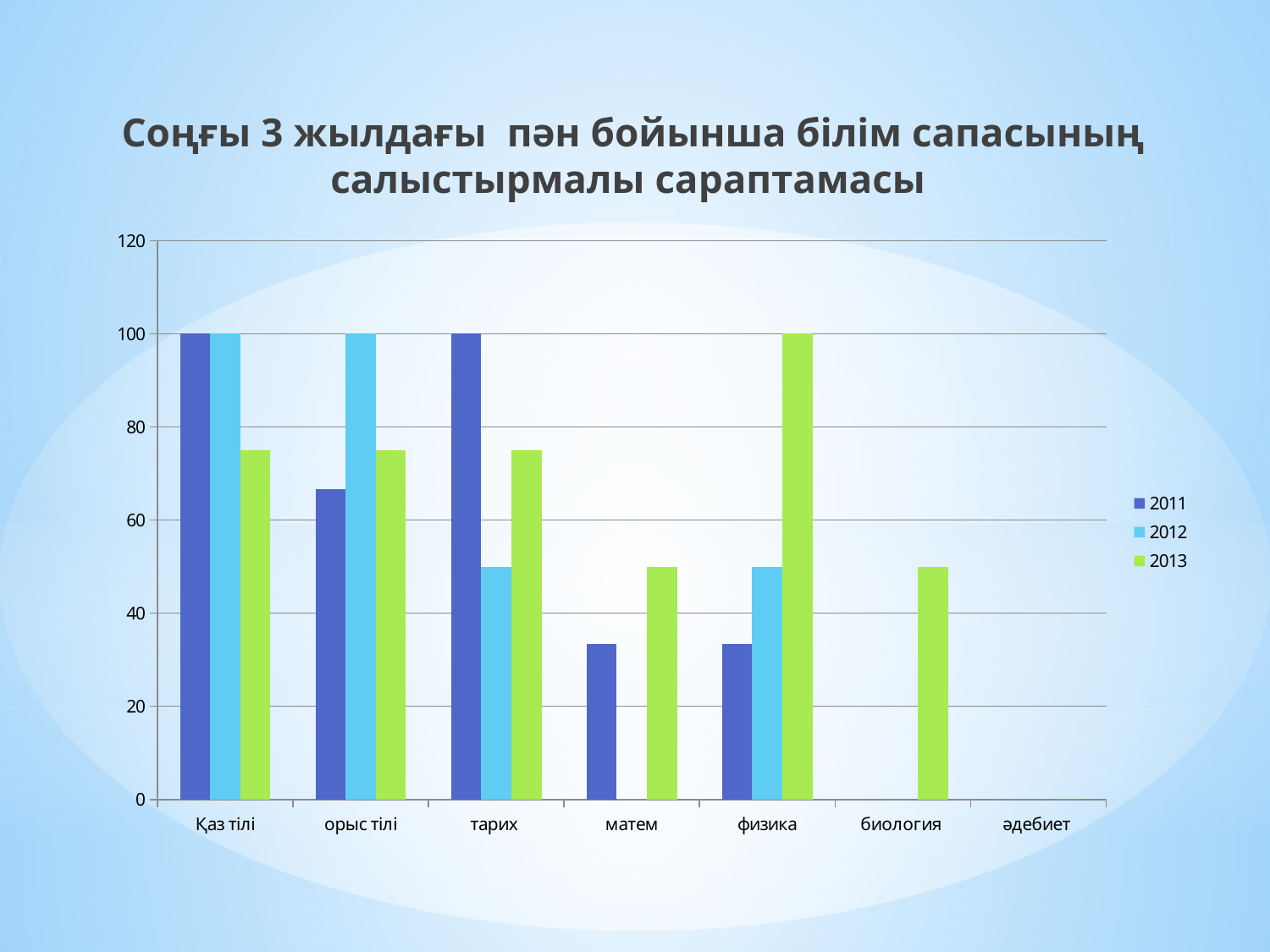
Is the value for орыс тілі in the 2011 series greater or less than 60? greater Is the value for матем in the 2011 series greater or less than 40? less What is the value for Қаз тілі in the 2011 series? 100 What kind of chart is shown on the slide? bar chart How many series does the legend list? 3 How many categories are shown on the x axis? 7 Which category has the highest value in the 2013 series? физика Which series is shown in green in the legend? 2013 What is the value for физика in the 2013 series? 100 Which is larger in the 2011 series: Қаз тілі or орыс тілі? Қаз тілі Is the value for биология in the 2013 series greater or less than 40? greater What is the value for орыс тілі in the 2012 series? 100